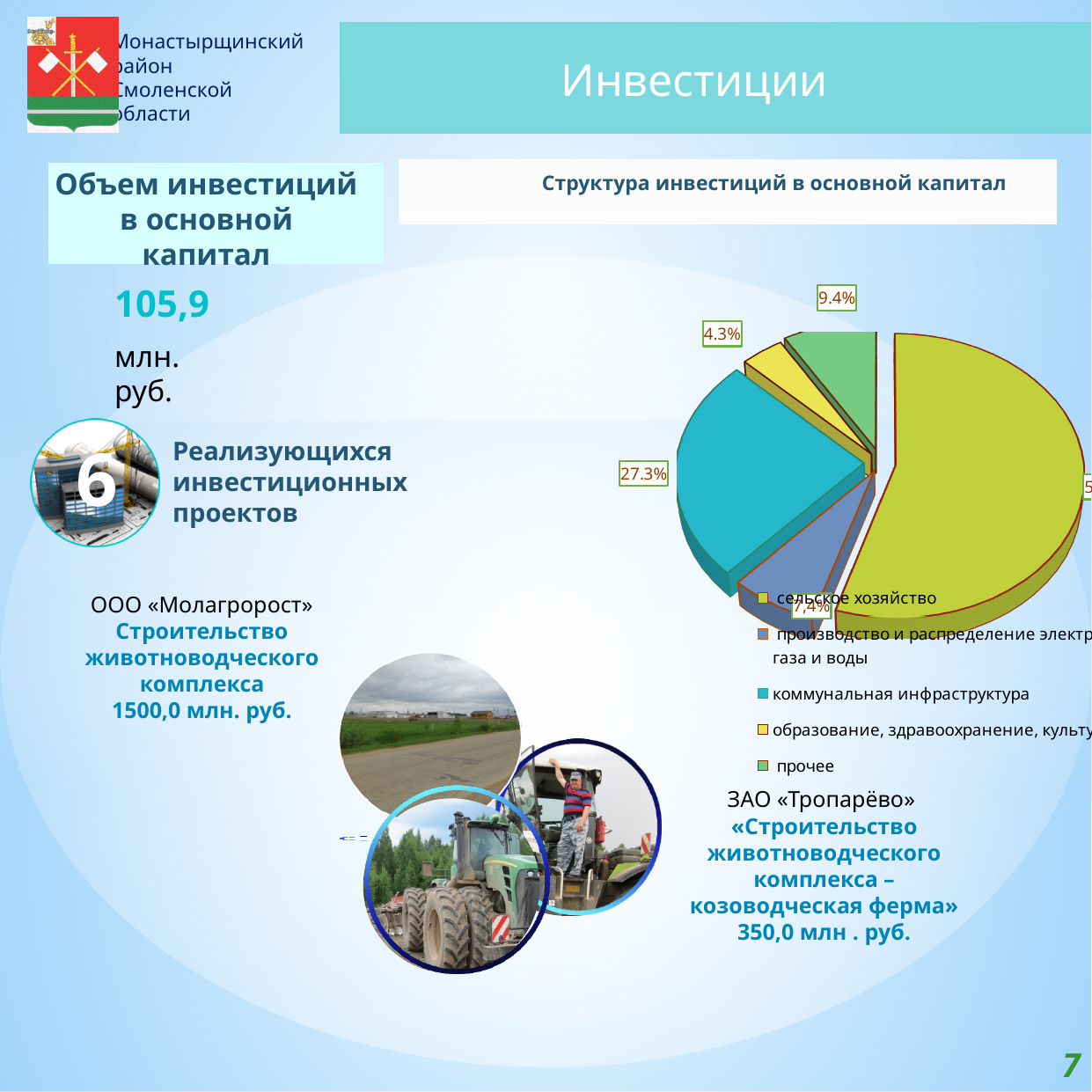
How many slices does the pie chart «Структура инвестиций в основной капитал» have? 5 Which category has the smallest slice in the pie chart? образование, здравоохранение, культура Which category has the largest slice in the pie chart? сельское хозяйство In the pie chart, what share is shown for «коммунальная инфраструктура»? 27.3% In the pie chart, which is larger: «коммунальная инфраструктура» or «прочее»? коммунальная инфраструктура In the pie chart, what share is shown for «прочее»? 9.4% What kind of chart is shown under the title «Структура инвестиций в основной капитал»? pie chart In the pie chart, what share is shown for «производство и распределение электроэнергии, газа и воды»? 7,4% How many entries does the legend of the pie chart list? 5 In the pie chart, by how many percentage points does «коммунальная инфраструктура» exceed «прочее»? 17.9% In the pie chart, what colour is the slice for «коммунальная инфраструктура»? teal (turquoise) In the pie chart, what share is shown for «образование, здравоохранение, культура»? 4.3%